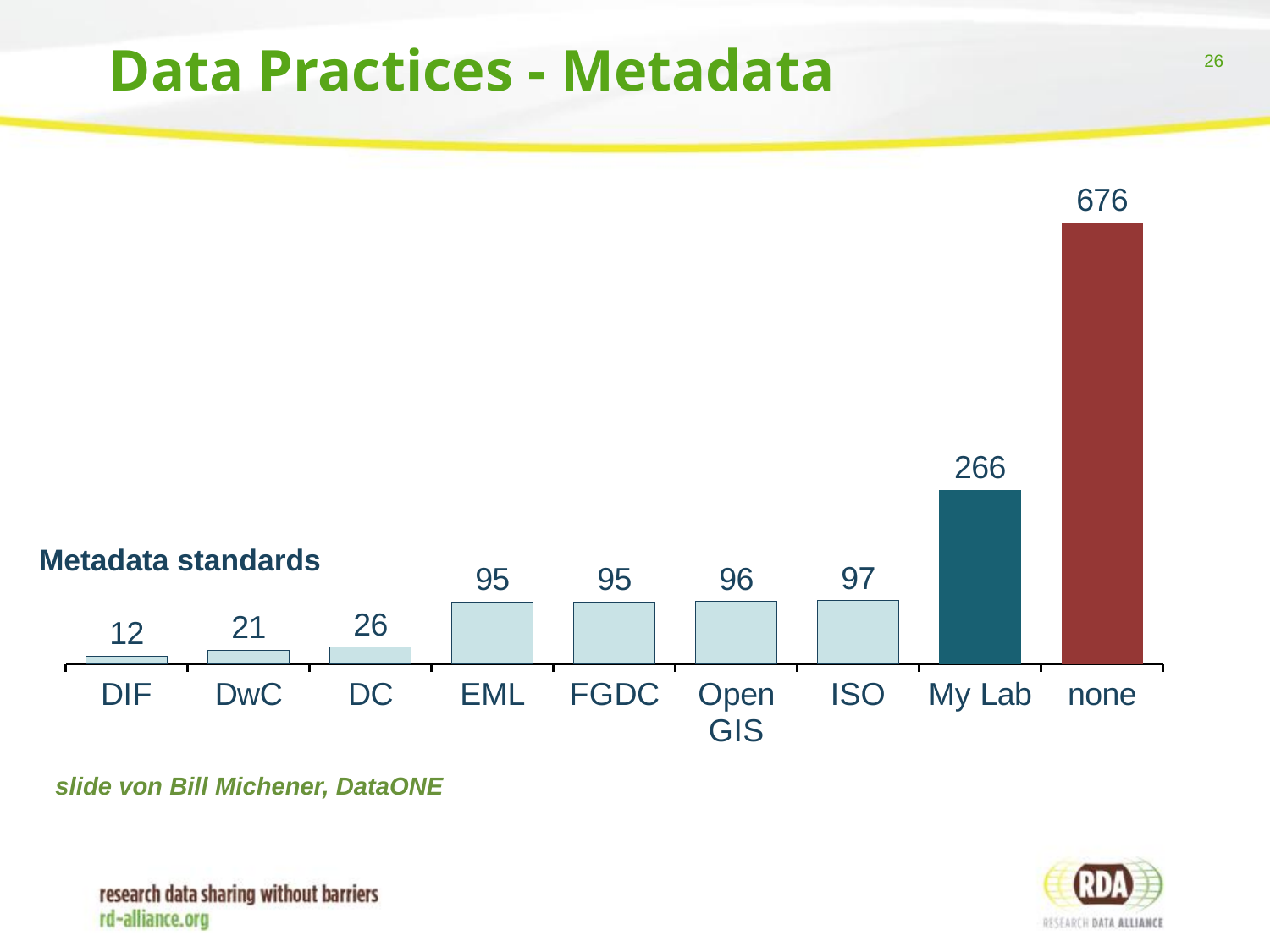
What colour is the bar for 'none' in the Metadata standards chart? Red How many categories are shown in the Metadata standards chart? 9 What is the difference between the values for DC and DwC? 5 What is the value for DIF in the Metadata standards chart? 12 Which category has the highest value in the Metadata standards chart? none What is the value for 'none' in the Metadata standards chart? 676 What is the value for 'My Lab' in the Metadata standards chart? 266 What is the value for ISO in the Metadata standards chart? 97 Which category has the lowest value in the Metadata standards chart? DIF What kind of chart is shown on the slide? Bar chart What is the difference between the values for 'none' and 'My Lab'? 410 Which is larger, the value for Open GIS or the value for EML? Open GIS